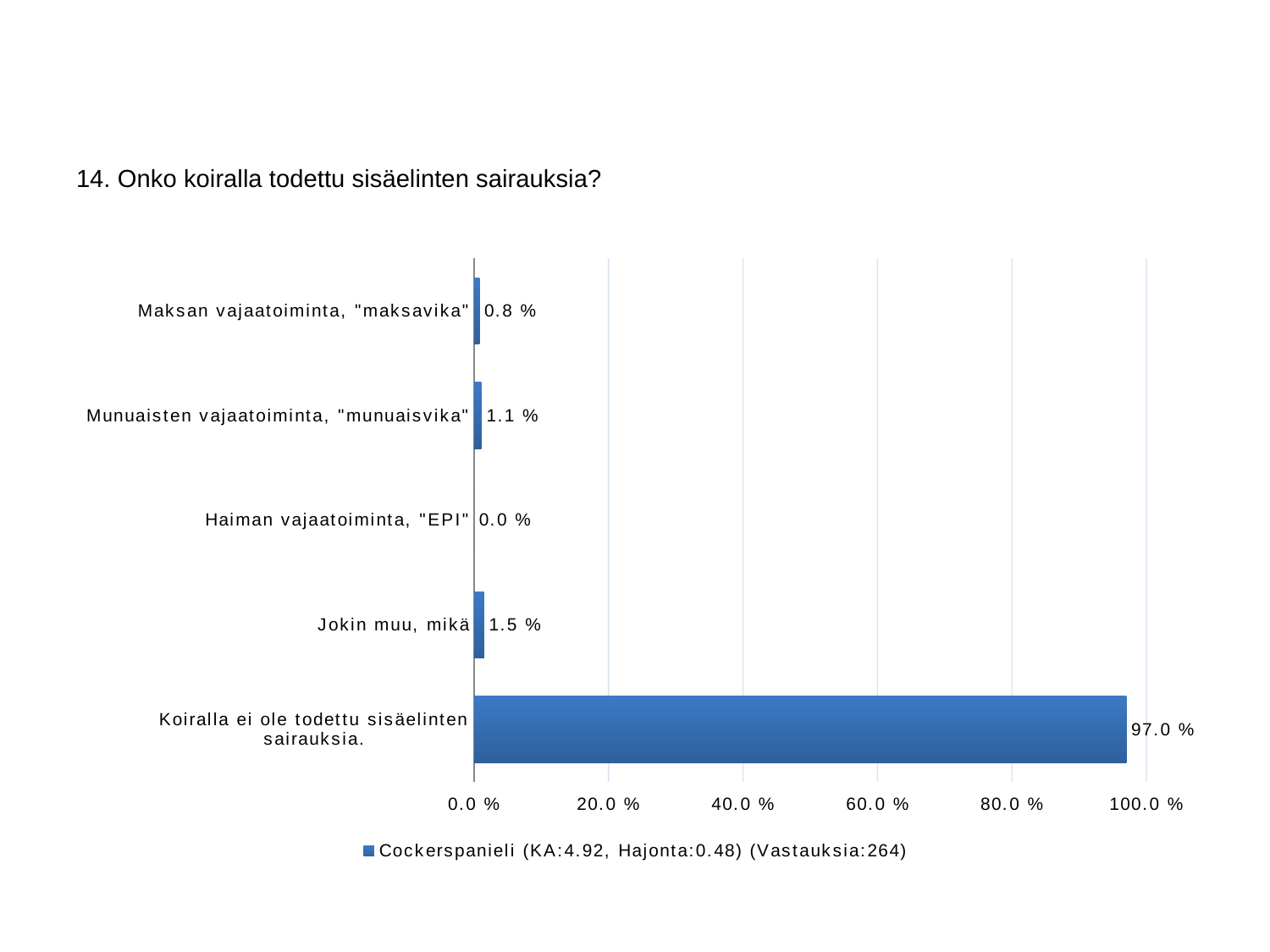
What is the value for "Maksan vajaatoiminta, \"maksavika\""? 0.8 % What is the value for "Jokin muu, mikä"? 1.5 % What is the value for "Koiralla ei ole todettu sisäelinten sairauksia."? 97.0 % What is the legend entry of the chart? Cockerspanieli (KA:4.92, Hajonta:0.48) (Vastauksia:264) Is the value for "Koiralla ei ole todettu sisäelinten sairauksia." greater or less than 80.0 %? greater How many categories are shown in the chart? 5 Which category has the highest value? Koiralla ei ole todettu sisäelinten sairauksia. Which category has the lowest value? Haiman vajaatoiminta, "EPI" What kind of chart is shown on the slide? bar chart What is the value for "Haiman vajaatoiminta, \"EPI\""? 0.0 % Which is larger: the value for "Munuaisten vajaatoiminta, \"munuaisvika\"" or the value for "Maksan vajaatoiminta, \"maksavika\""? Munuaisten vajaatoiminta, "munuaisvika" What is the difference between the values for "Jokin muu, mikä" and "Munuaisten vajaatoiminta, \"munuaisvika\""? 0.4 %